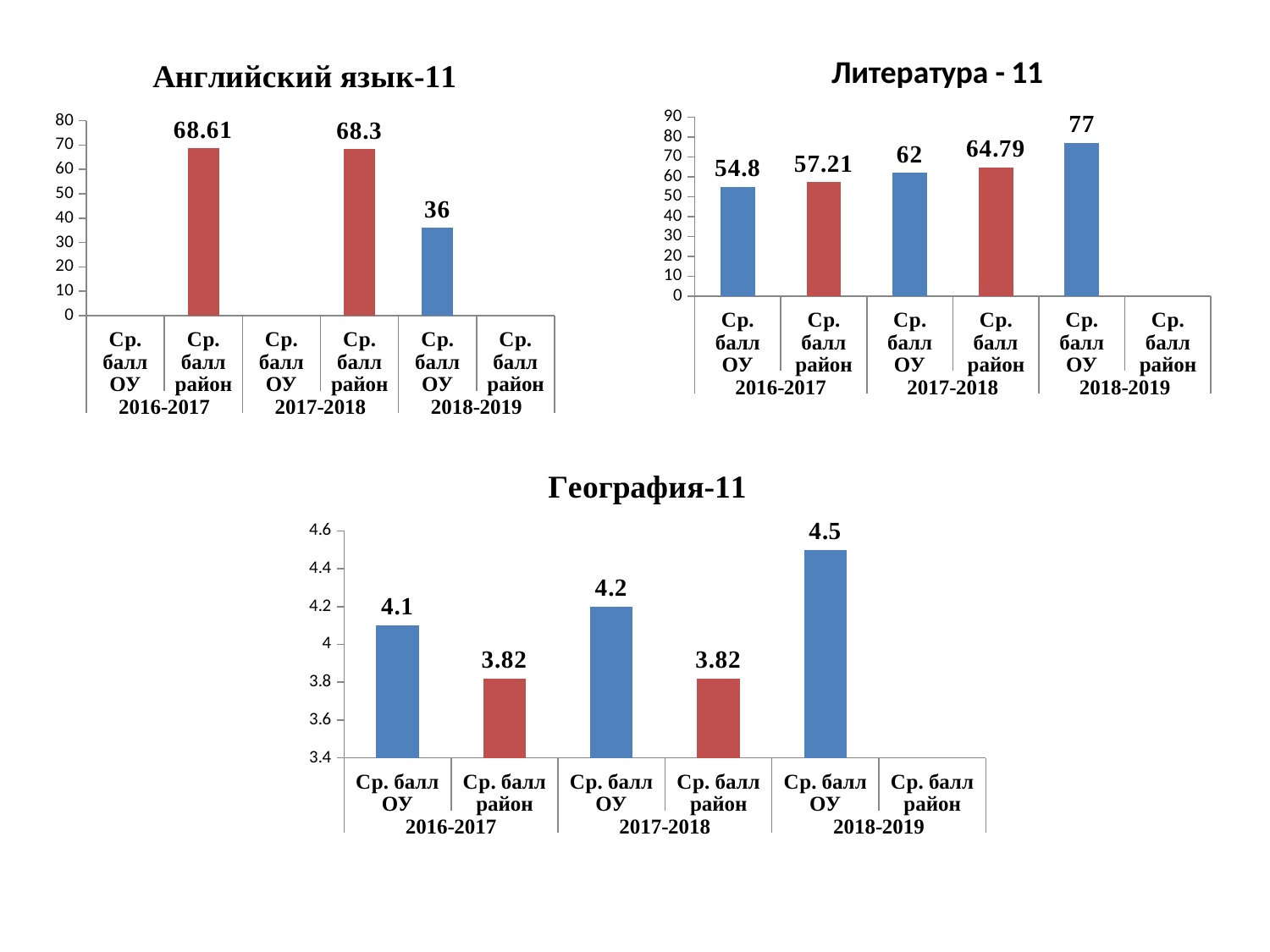
In the chart titled "Английский язык-11", which labelled bar has the lowest value? Ср. балл ОУ 2018-2019 In the chart titled "География-11", do the Ср. балл ОУ values rise or fall from 2016-2017 to 2018-2019? rise How many year groups are shown on the x axis of the chart titled "Литература - 11"? 3 In the chart titled "Английский язык-11", what is the value for Ср. балл район in 2016-2017? 68.61 What is the title of the chart at the bottom of the slide? География-11 In the chart titled "География-11", what is the value for Ср. балл район in 2017-2018? 3.82 What kind of chart is the chart titled "География-11"? bar chart In the chart titled "География-11", which is larger in 2016-2017: Ср. балл ОУ or Ср. балл район? Ср. балл ОУ In the chart titled "Литература - 11", what is the value for Ср. балл ОУ in 2018-2019? 77 In the chart titled "Литература - 11", which bar has the highest value? Ср. балл ОУ 2018-2019 In the chart titled "Литература - 11", is the value for Ср. балл ОУ in 2016-2017 greater or less than 60? less In the chart titled "Литература - 11", what is the difference between Ср. балл район and Ср. балл ОУ in 2017-2018? 2.79